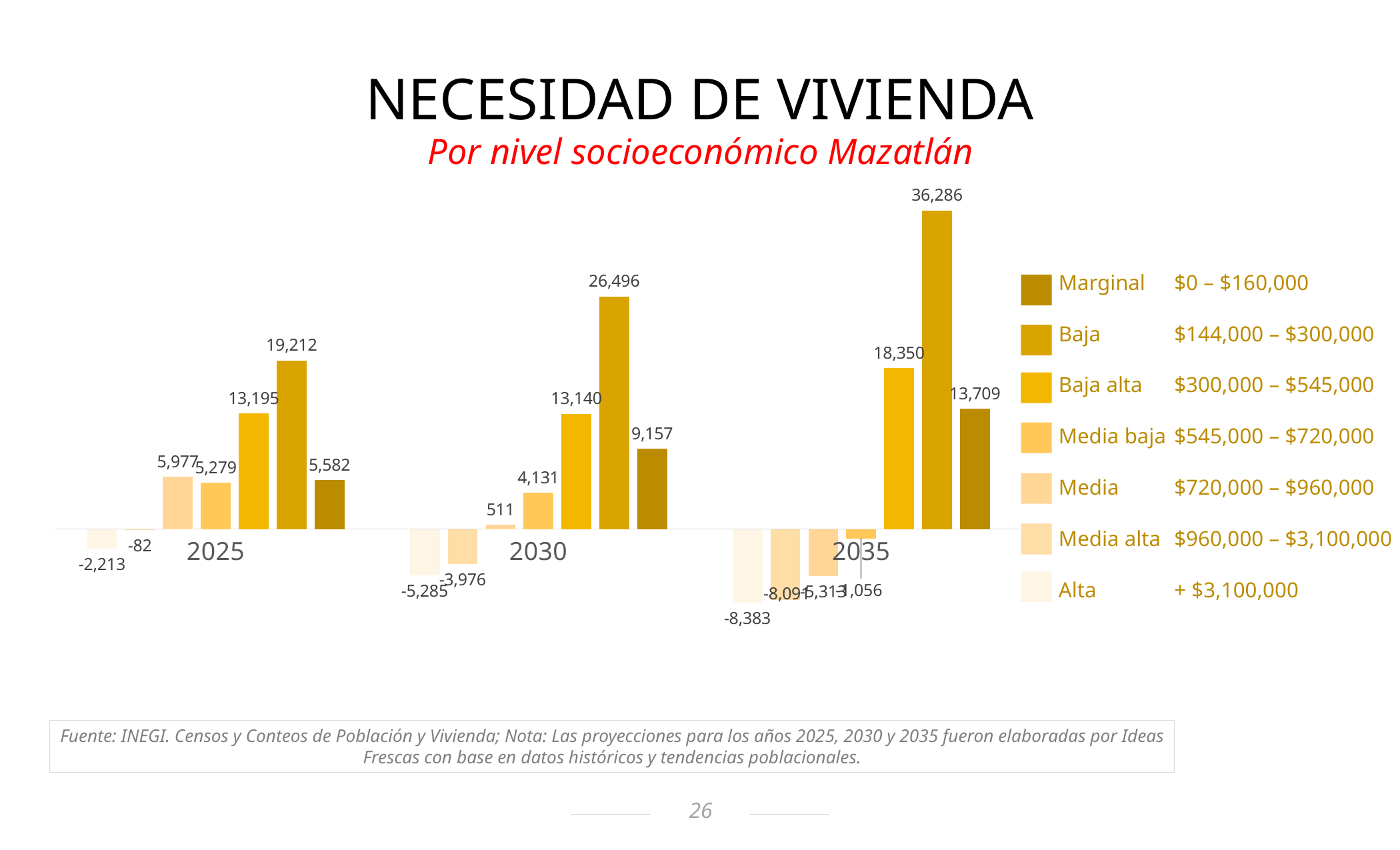
What is the difference between the Baja values for 2035 and 2030? 9,790 Which year has the highest value for Baja? 2035 What is the value for Baja alta in 2035? 18,350 Which is larger in 2025: the value for Media or the value for Media baja? Media What price range does the legend give for Baja alta? $300,000 – $545,000 How many year groups are shown on the x axis? 3 What kind of chart is shown on the slide? Bar chart What is the value for Marginal in 2030? 9,157 How many series does the legend list? 7 Which series has the lowest value in 2035? Alta What is the value for Baja in 2035? 36,286 What is the value for Alta in 2025? -2,213